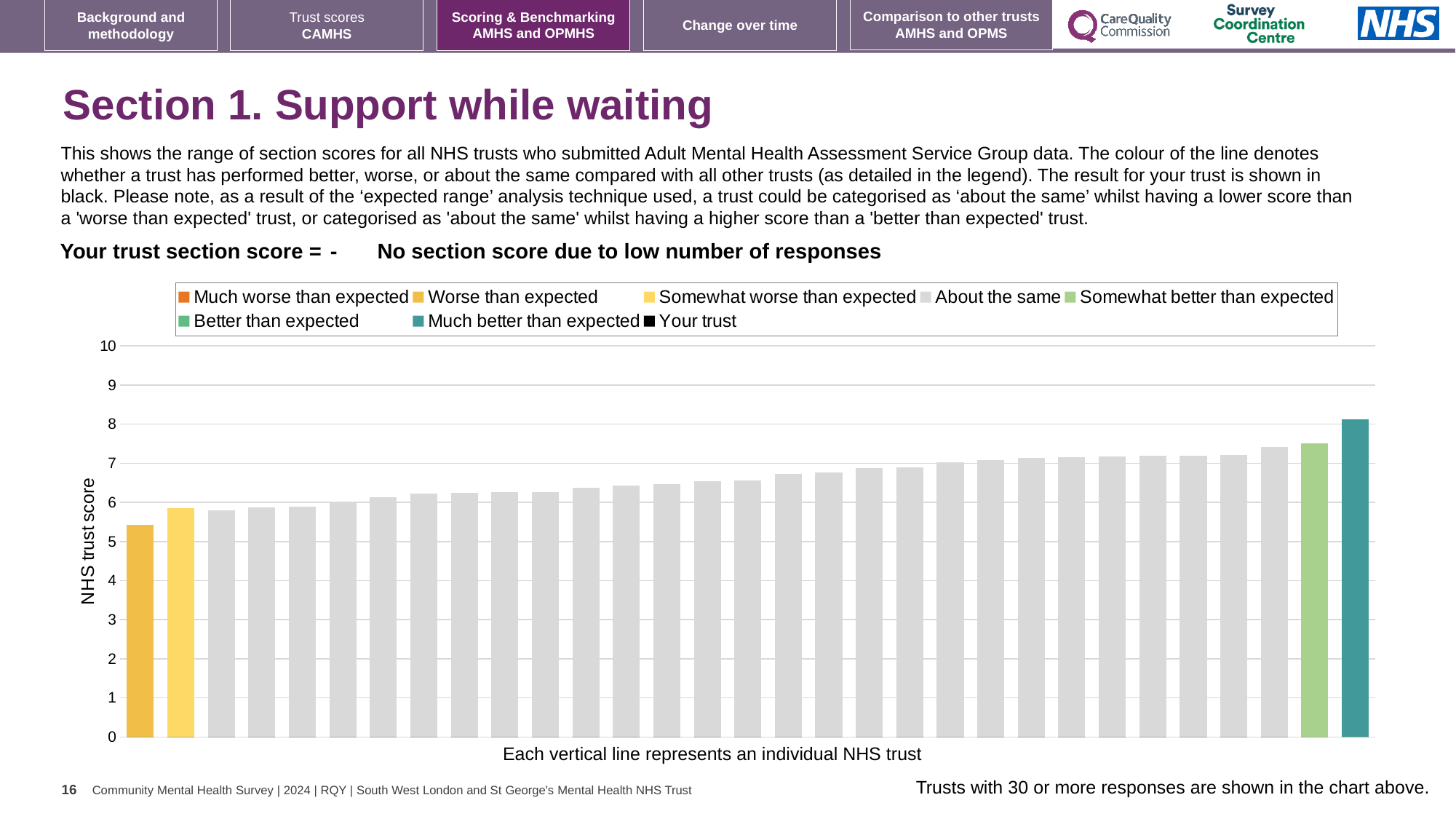
Do the bar values rise or fall from left to right across the chart? Rise Which is larger, the leftmost bar or the rightmost bar? The rightmost bar Is the value of the rightmost bar greater or less than 7? greater What kind of chart is shown on the slide? Bar chart Is the value of the leftmost bar greater or less than 6? less Which bar has the lowest NHS trust score? The leftmost bar According to the legend, which category does the colour of the rightmost bar represent? Much better than expected How many entries does the chart legend list? 8 What is the label on the vertical axis of the chart? NHS trust score Is the value of the leftmost bar greater or less than 5? greater Which bar has the highest NHS trust score? The rightmost bar